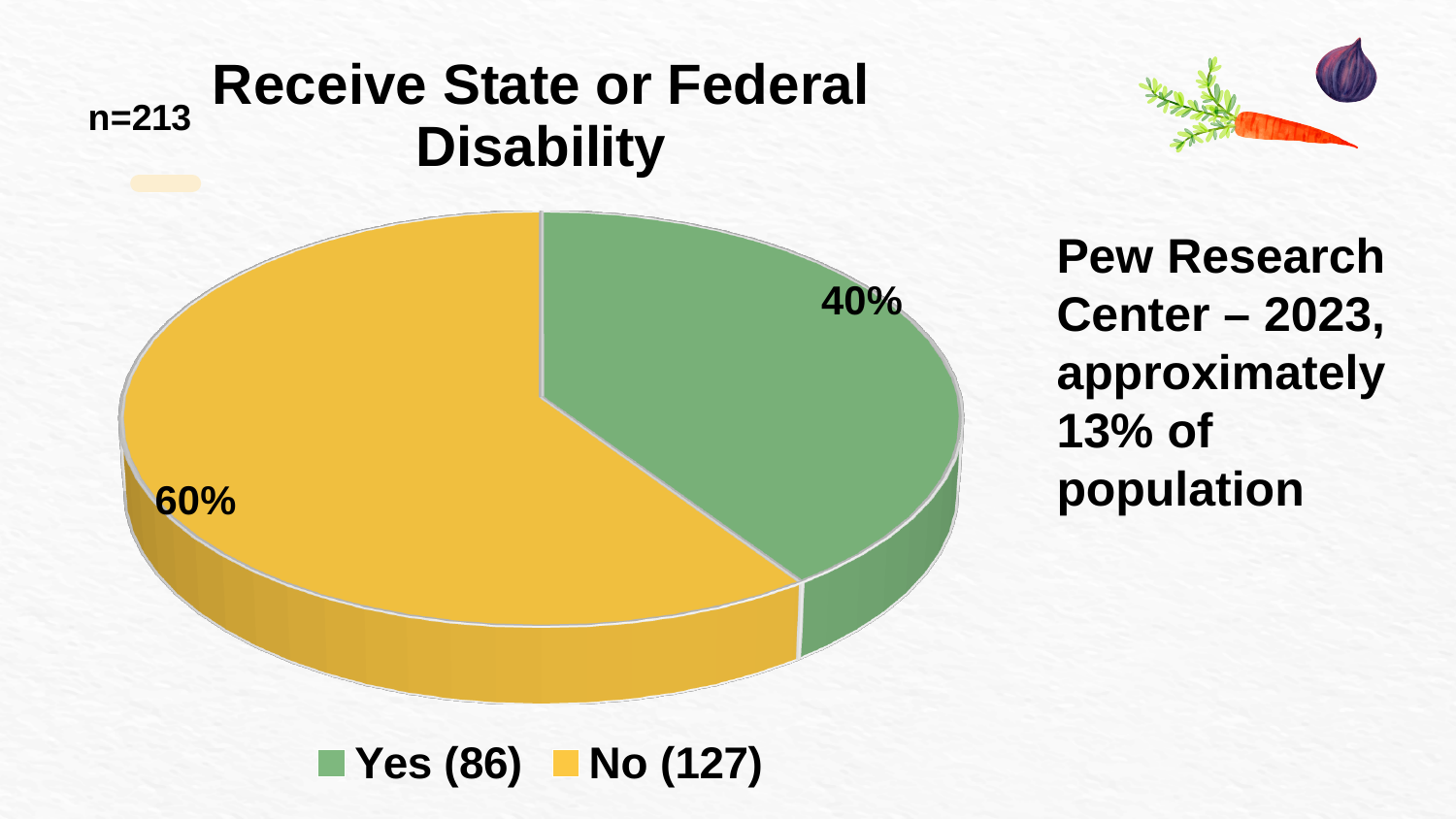
How many respondents answered Yes, according to the legend? 86 Which category has the larger share of the pie? No What percentage of respondents answered Yes? 40% What percentage of respondents answered No? 60% Which category has the smaller share of the pie? Yes What type of chart is shown on the slide? Pie chart What is the title of the chart? Receive State or Federal Disability How many categories does the pie chart show? 2 What colour is the Yes slice? Green What is the difference in percentage points between the No and Yes slices? 20 percentage points How many respondents answered No, according to the legend? 127 What is the total sample size (n) shown on the slide? 213